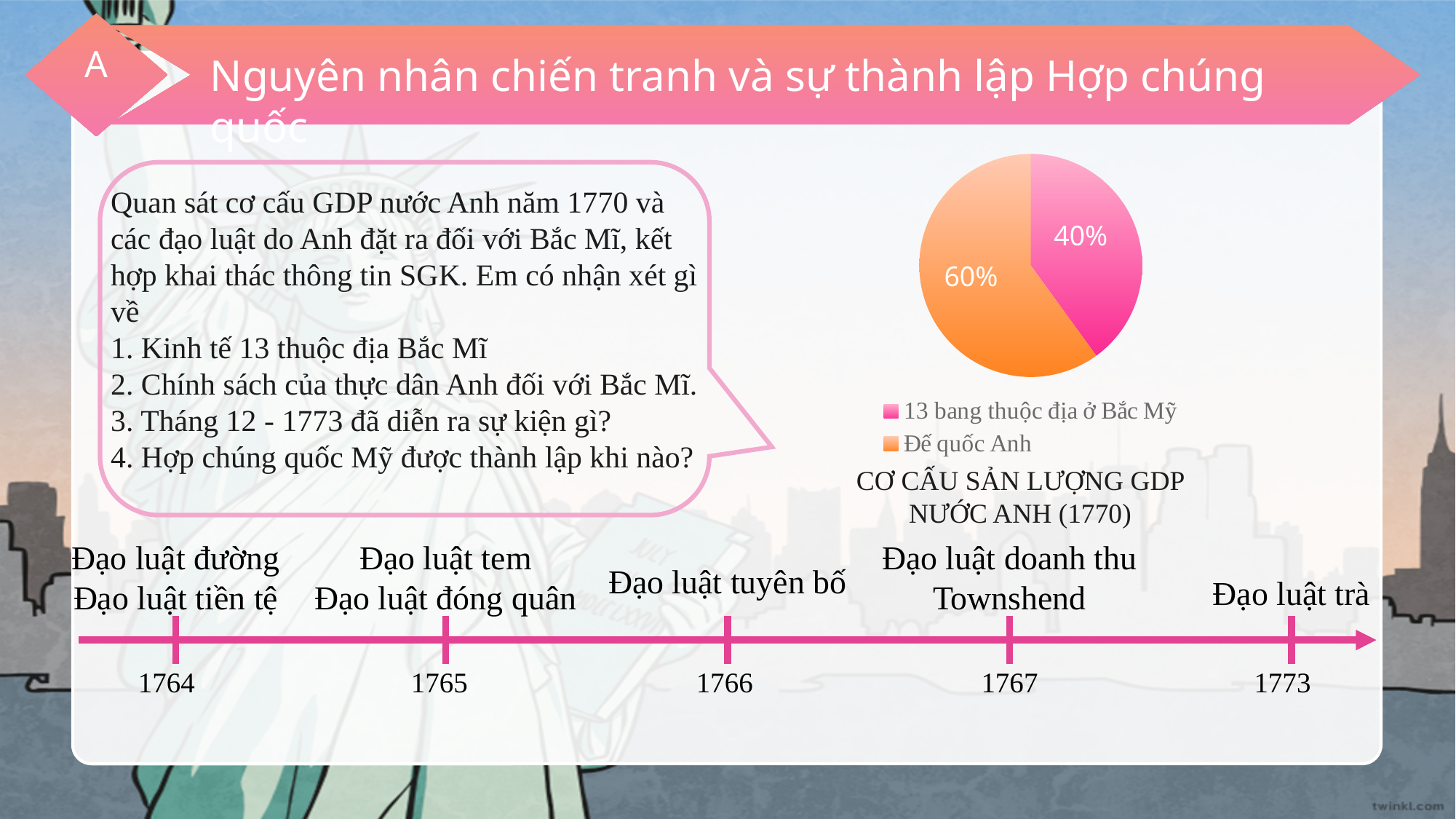
Which is larger in the pie chart: "Đế quốc Anh" or "13 bang thuộc địa ở Bắc Mỹ"? Đế quốc Anh How many slices does the pie chart have? 2 What share of the pie chart is labelled "13 bang thuộc địa ở Bắc Mỹ"? 40% What colour is the "Đế quốc Anh" slice in the pie chart? Orange What share of the pie chart is labelled "Đế quốc Anh"? 60% What is the title of the pie chart? CƠ CẤU SẢN LƯỢNG GDP NƯỚC ANH (1770) What is the difference in percentage points between the "Đế quốc Anh" slice and the "13 bang thuộc địa ở Bắc Mỹ" slice? 20% Is the share for "13 bang thuộc địa ở Bắc Mỹ" greater or less than 50%? less How many entries does the pie chart legend list? 2 What type of chart is shown on the slide? Pie chart Which slice of the pie chart is the largest? Đế quốc Anh Which slice of the pie chart is the smallest? 13 bang thuộc địa ở Bắc Mỹ